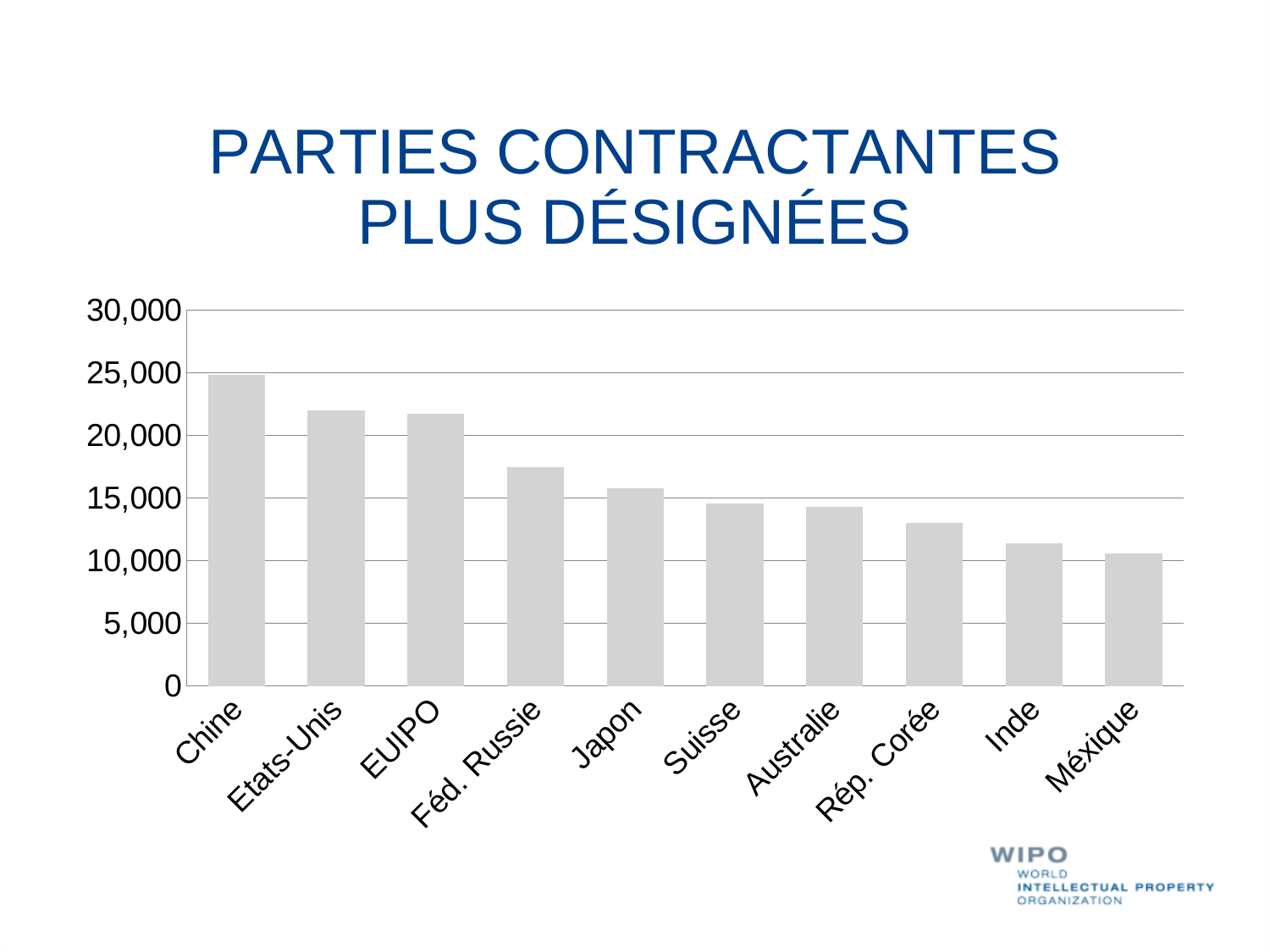
Is the value for Inde greater or less than 10,000? greater How many contracting parties are shown on the x axis? 10 What is the title of the slide containing the chart? PARTIES CONTRACTANTES PLUS DÉSIGNÉES Do the values rise or fall moving from left to right along the x axis? Fall Is the value for Etats-Unis greater or less than 20,000? greater Which is larger, the value for Chine or the value for Etats-Unis? Chine Which contracting party has the lowest bar in the chart? Méxique Which contracting party has the highest bar in the chart? Chine Is the value for Rép. Corée greater or less than 15,000? less What kind of chart is shown on the slide? Bar chart